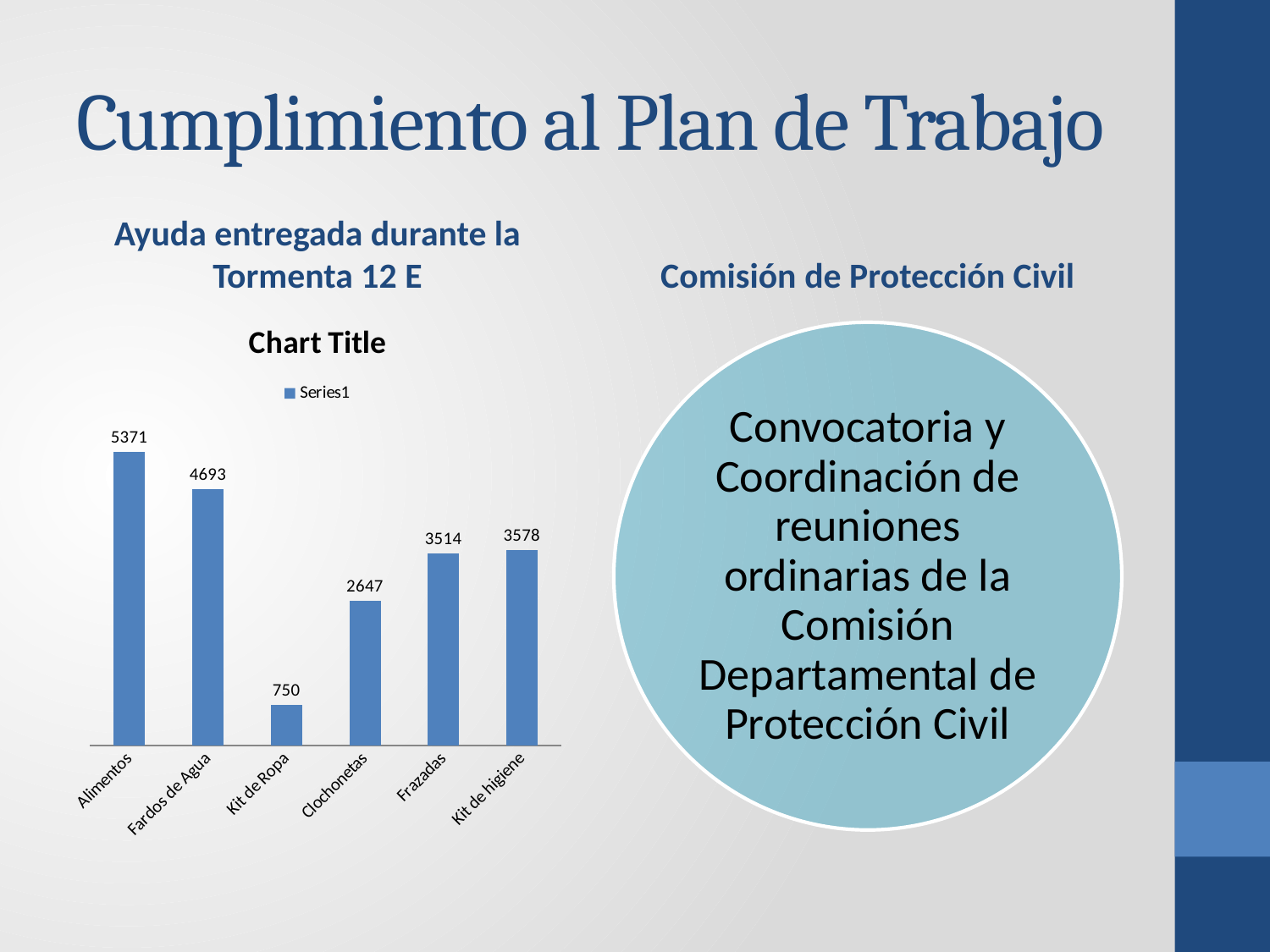
What is the value for Kit de Ropa? 750 What kind of chart is shown on the slide? Bar chart How many categories are shown in the chart? 6 What is the difference between the values for Alimentos and Fardos de Agua? 678 How many series does the legend list? 1 What is the value for Alimentos? 5371 What is the value for Clochonetas? 2647 Which category has the highest value? Alimentos What is the value for Kit de higiene? 3578 Which category has the lowest value? Kit de Ropa Which is larger, the value for Fardos de Agua or the value for Frazadas? Fardos de Agua What is the difference between the values for Frazadas and Clochonetas? 867